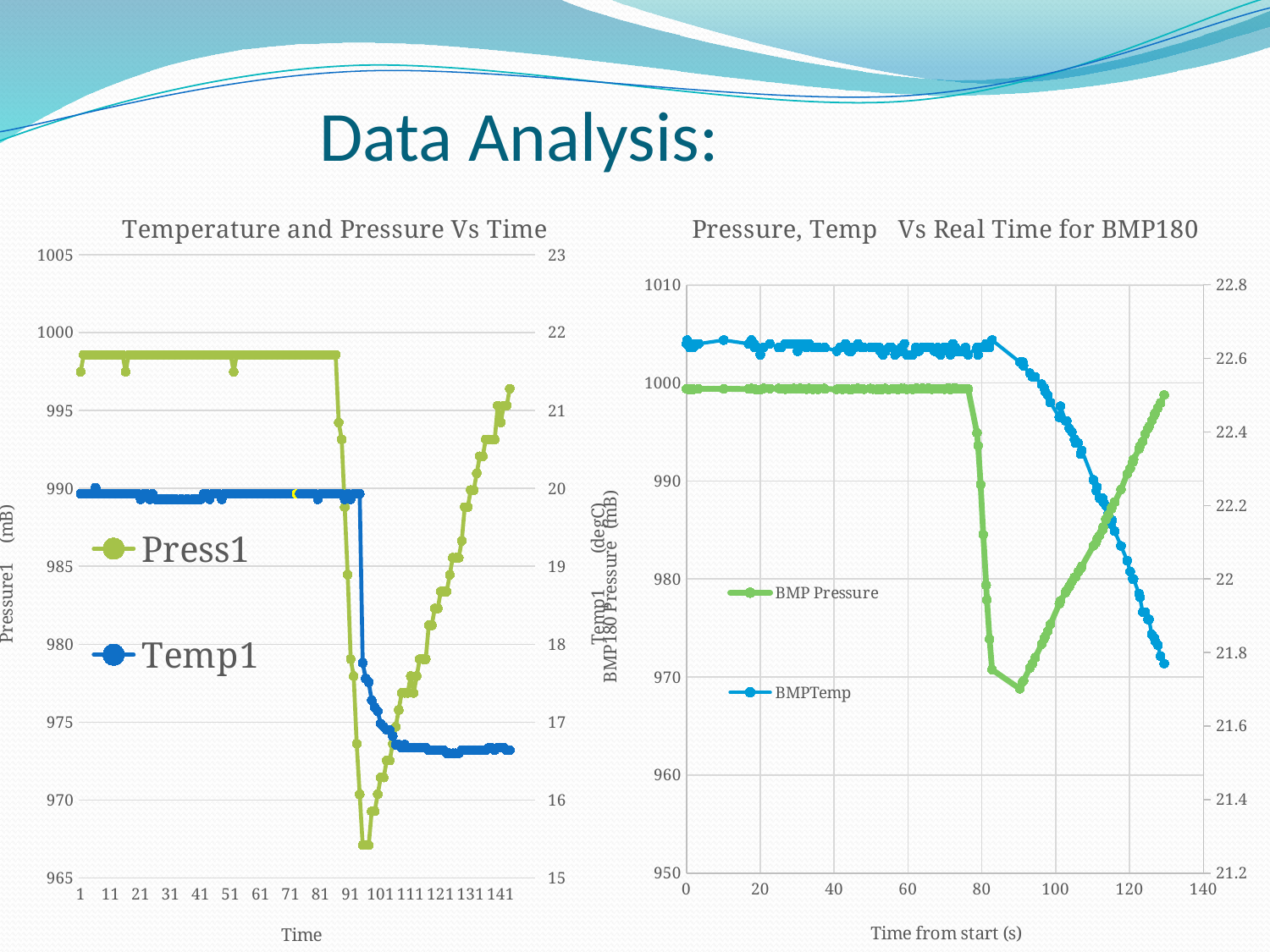
In the right chart "Pressure, Temp Vs Real Time for BMP180", what are the two series named in the legend? BMP Pressure and BMPTemp In the right chart "Pressure, Temp Vs Real Time for BMP180", is the BMPTemp value at about 130 s greater or less than 22? less In the right chart "Pressure, Temp Vs Real Time for BMP180", is the BMP Pressure value at 0 s greater or less than 990? greater In the left chart "Temperature and Pressure Vs Time", is the Temp1 value at the end of the series (x = 141) greater or less than 18? less How many series does the legend of the right chart "Pressure, Temp Vs Real Time for BMP180" list? 2 What kind of chart is the left chart titled "Temperature and Pressure Vs Time"? line chart How many series does the legend of the left chart "Temperature and Pressure Vs Time" list? 2 In the right chart "Pressure, Temp Vs Real Time for BMP180", what is the label of the x axis? Time from start (s) What kind of chart is the right chart titled "Pressure, Temp Vs Real Time for BMP180"? line chart In the right chart "Pressure, Temp Vs Real Time for BMP180", does the BMPTemp series rise or fall between 80 s and 130 s? fall